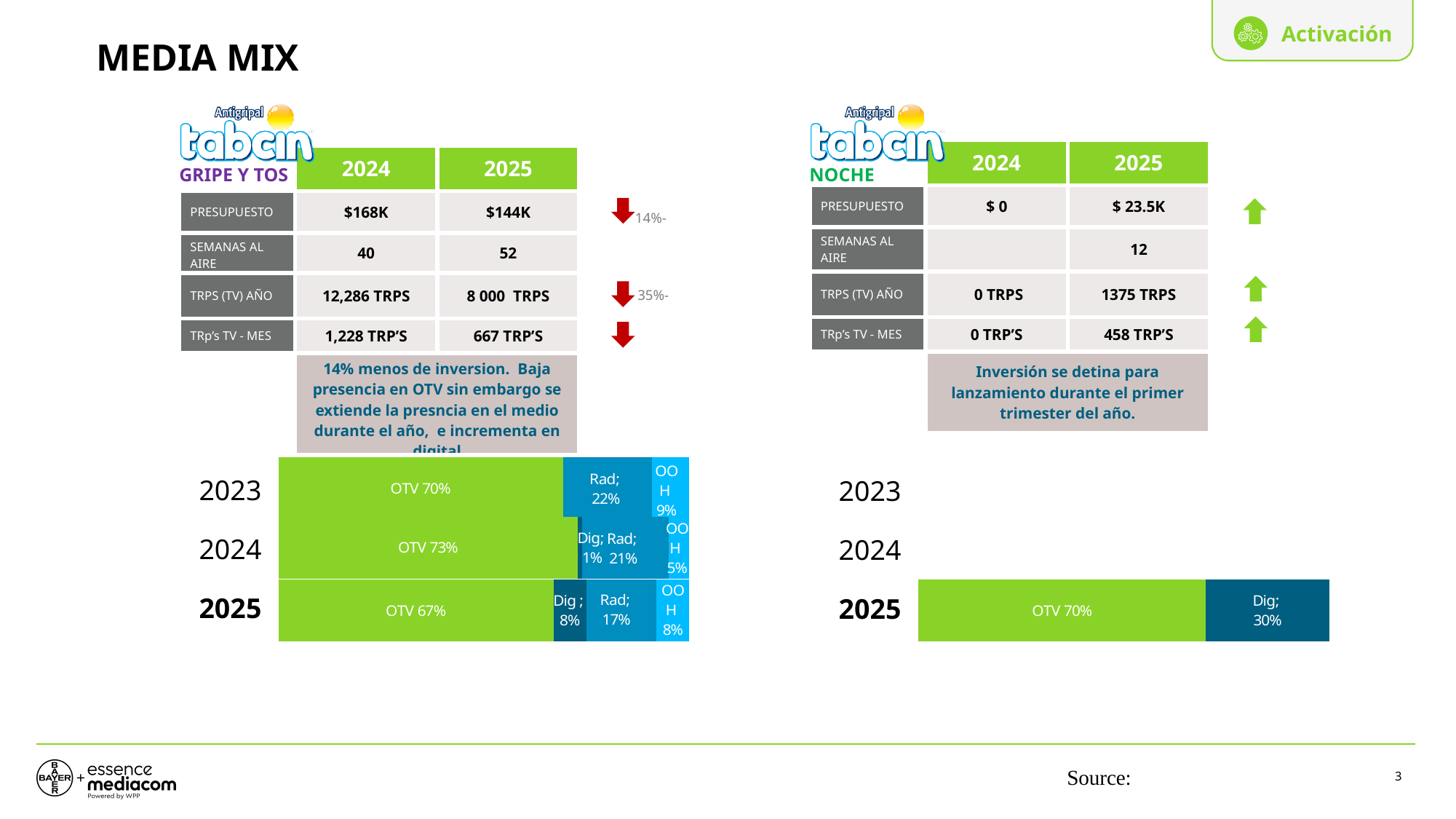
In the right chart (Noche media mix), what is the OTV share for 2025? 70% What kind of chart is the left chart (Gripe y Tos media mix)? Stacked bar chart In the left chart (Gripe y Tos media mix), is the Rad share or the Dig share larger in 2025? Rad How many years are shown with bars in the left chart (Gripe y Tos media mix)? 3 In the left chart (Gripe y Tos media mix), does the Rad share rise or fall from 2023 to 2025? Fall In the left chart (Gripe y Tos media mix), what is the Rad share for 2023? 22% In the right chart (Noche media mix), is the OTV share or the Dig share larger in 2025? OTV In the left chart (Gripe y Tos media mix), what is the OOH share for 2024? 5% In the left chart (Gripe y Tos media mix), what is the Dig share for 2025? 8% In the left chart (Gripe y Tos media mix), by how many percentage points does the OTV share in 2024 exceed the OTV share in 2025? 6 percentage points In the left chart (Gripe y Tos media mix), which year has the highest OTV share? 2024 In the left chart (Gripe y Tos media mix), what is the OTV share for 2025? 67%